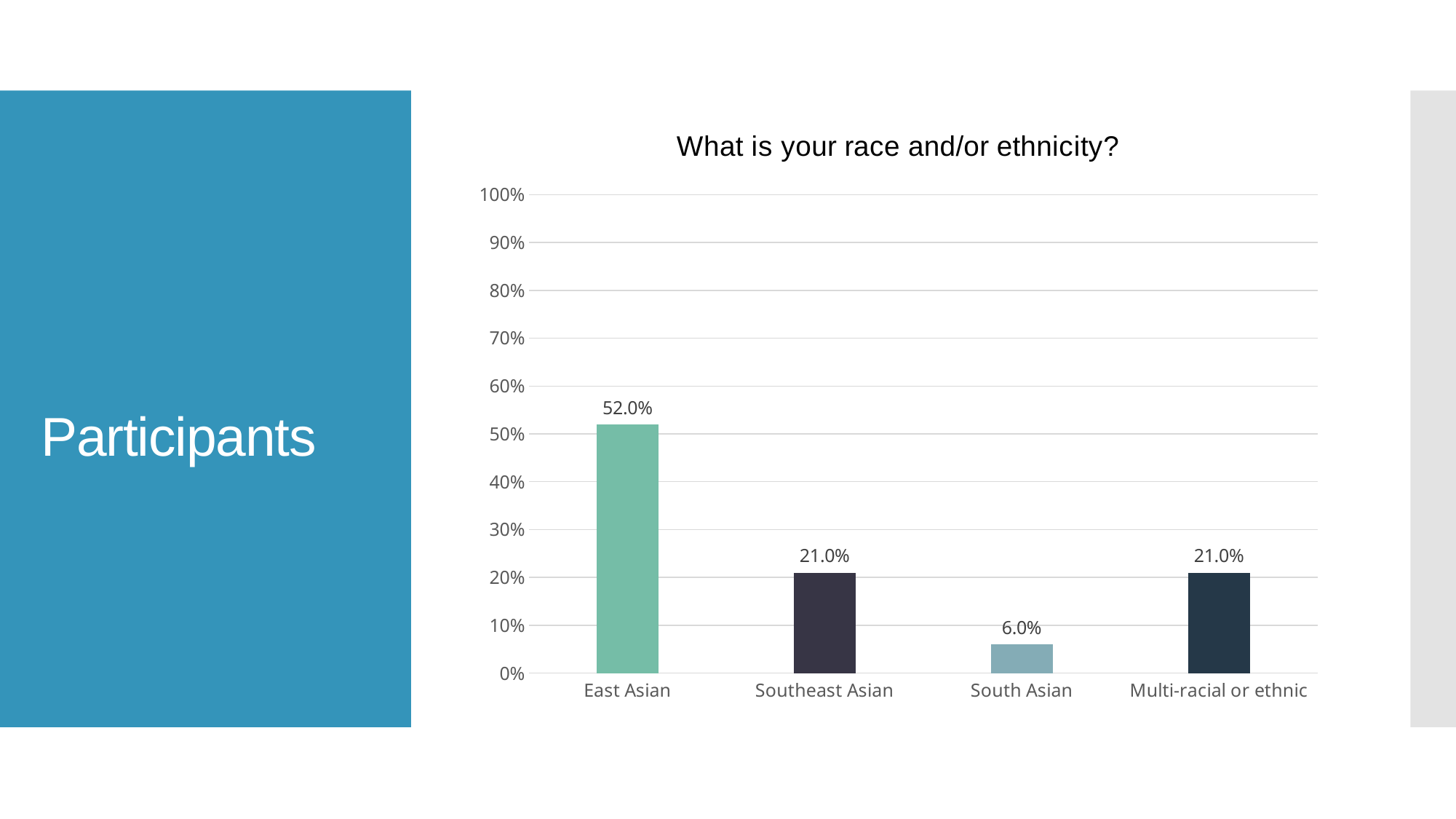
What kind of chart is shown on the slide? bar chart What is the value for Multi-racial or ethnic? 21.0% What is the title of the chart? What is your race and/or ethnicity? Which category has the lowest value? South Asian Which is larger, the value for East Asian or the value for Multi-racial or ethnic? East Asian How many categories are shown on the x axis? 4 Which category has the highest value? East Asian Is the value for East Asian greater or less than 50%? greater What is the difference between the values for East Asian and Southeast Asian? 31.0% What is the difference between the values for Southeast Asian and South Asian? 15.0% What is the value for East Asian? 52.0% What is the value for South Asian? 6.0%